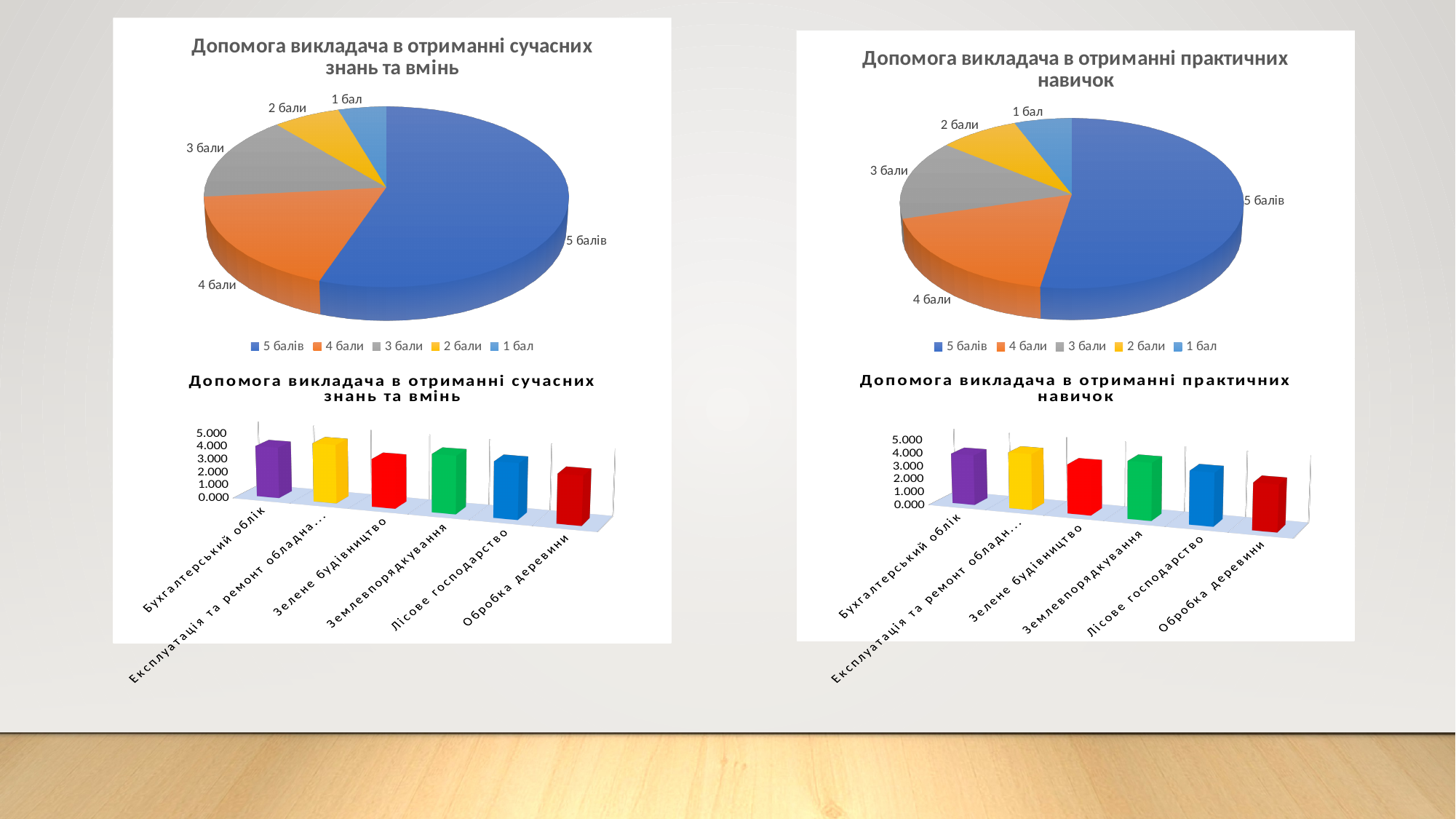
What kind of chart is the bottom-right chart titled "Допомога викладача в отриманні практичних навичок"? bar chart In the top-left pie chart, which slice is the largest? 5 балів What is the title of the top-right pie chart? Допомога викладача в отриманні практичних навичок In the top-right pie chart, how many entries does the legend list? 5 In the bottom-left bar chart, how many categories are shown on the x axis? 6 In the top-right pie chart, which slice is the smallest? 1 бал In the top-right pie chart, which slice is larger: 4 бали or 3 бали? 4 бали In the top-left pie chart, how many slices are there? 5 In the bottom-right bar chart, is the value for Бухгалтерський облік greater or less than 3.000? greater What kind of chart is the top-left chart titled "Допомога викладача в отриманні сучасних знань та вмінь"? pie chart In the bottom-right bar chart, which bar is taller: Зелене будівництво or Обробка деревини? Зелене будівництво